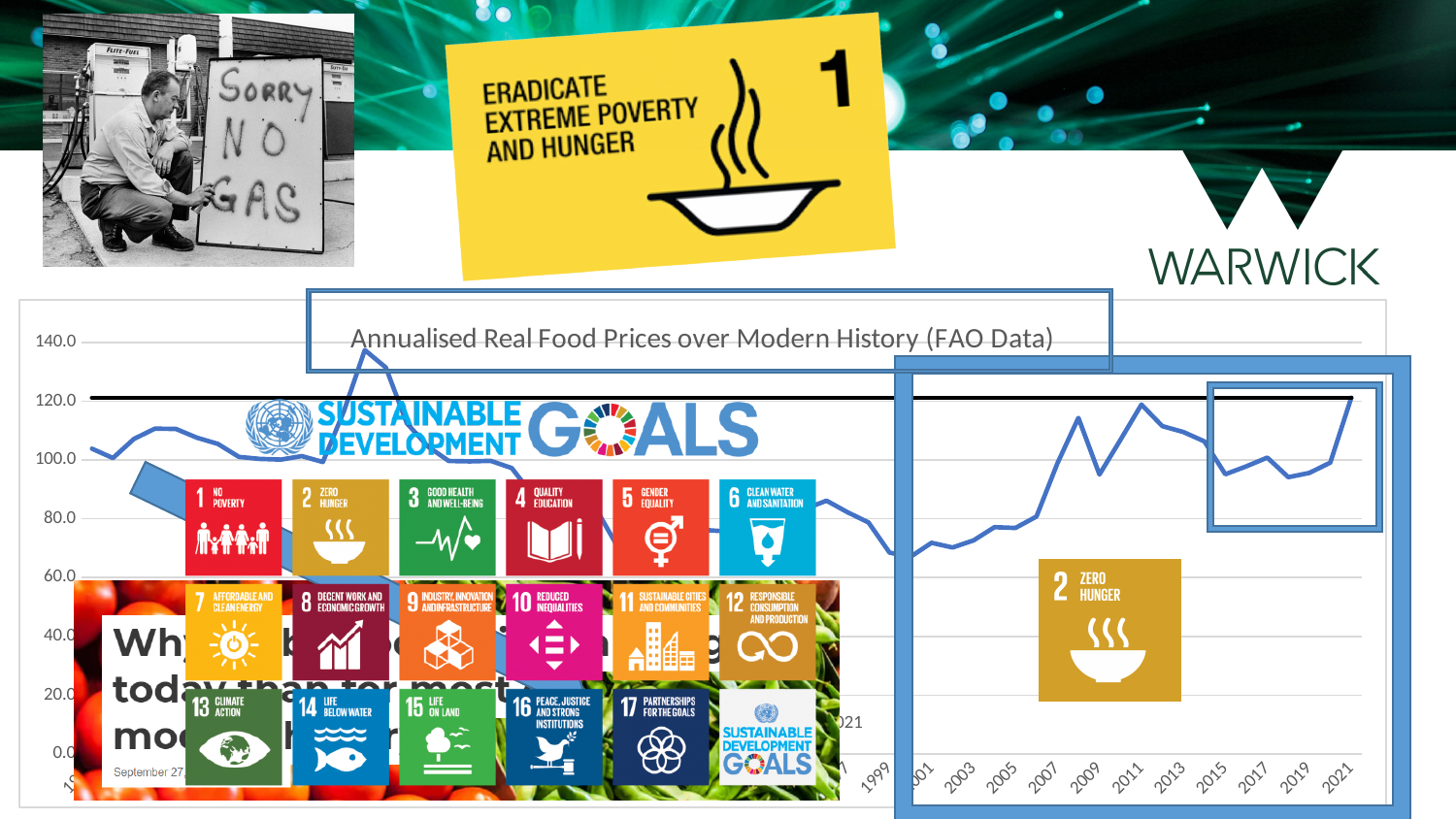
Is the value for 2021 greater or less than 100? greater Is the value for 2011 greater or less than 100? greater Which year has the larger value, 2019 or 2021? 2021 Do the values generally rise or fall between 2011 and 2016? fall What kind of chart is shown on the slide? line chart Is the value for 2005 greater or less than 100? less What is the title of the chart? Annualised Real Food Prices over Modern History (FAO Data) Do the values generally rise or fall between 2001 and 2011? rise Which year has the larger value, 2001 or 2011? 2011 What is the highest value shown on the chart's vertical axis? 140.0